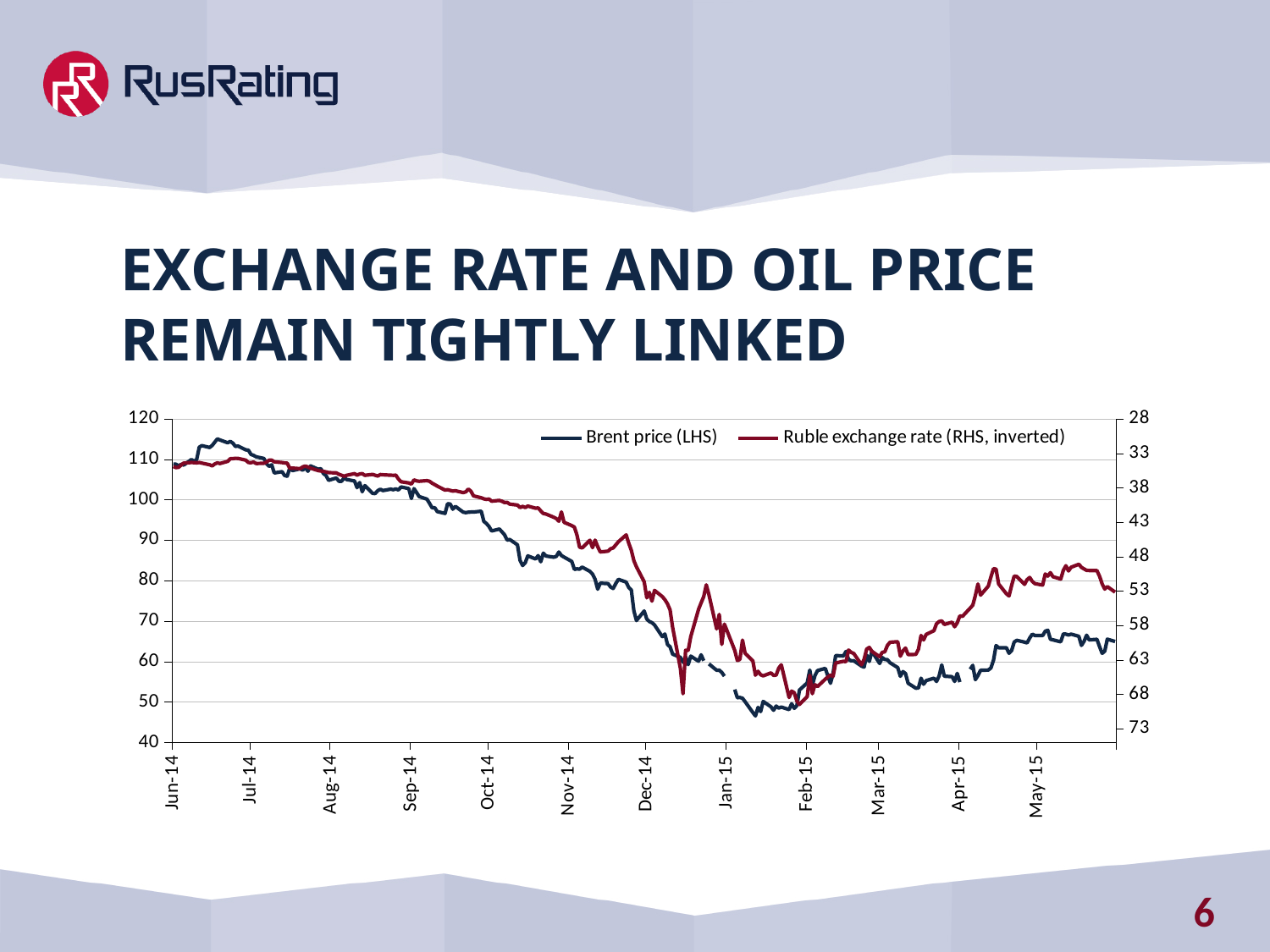
What are the two series named in the chart legend? Brent price (LHS) and Ruble exchange rate (RHS, inverted) How many month labels are shown on the x axis? 12 Is the Brent price (LHS) at May-15 greater or less than 60? greater Does the Brent price (LHS) line rise or fall between Jun-14 and Jan-15? fall Does the Brent price (LHS) line rise or fall between Feb-15 and May-15? rise Is the Brent price (LHS) at Jun-14 greater or less than 100? greater Is the Brent price (LHS) at Feb-15 greater or less than 60? less How many series does the chart legend list? 2 What kind of chart is shown on the slide? line chart What colour is the Brent price (LHS) line? dark blue